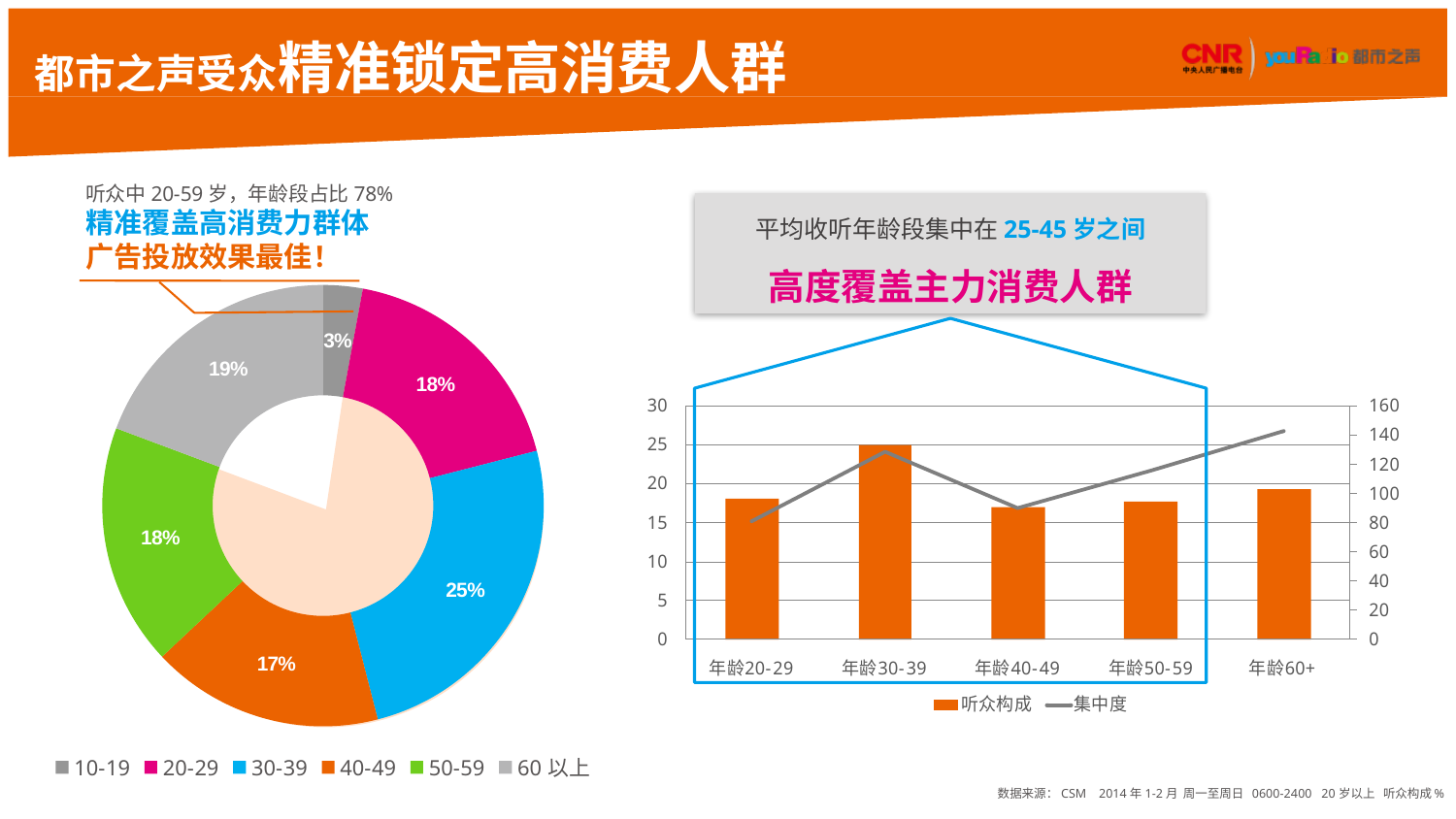
In the donut chart on the left, what share of listeners is in the 30-39 age group? 25% In the donut chart on the left, which is larger: the share for 60 以上 or the share for 40-49? 60 以上 In the donut chart on the left, which age group has the largest share? 30-39 In the chart on the right, which age group has the highest 集中度 value? 年龄60+ How many age groups does the legend of the donut chart on the left list? 6 In the chart on the right, is the 集中度 value for 年龄20-29 greater or less than 100? less How many series does the legend of the chart on the right list? 2 In the donut chart on the left, what share of listeners is in the 10-19 age group? 3% In the donut chart on the left, which age group has the smallest share? 10-19 In the chart on the right, is the 听众构成 value for 年龄30-39 greater or less than 20? greater In the donut chart on the left, what is the difference between the shares of the 30-39 and 40-49 age groups? 8% In the chart on the right, which age group has the tallest 听众构成 bar? 年龄30-39